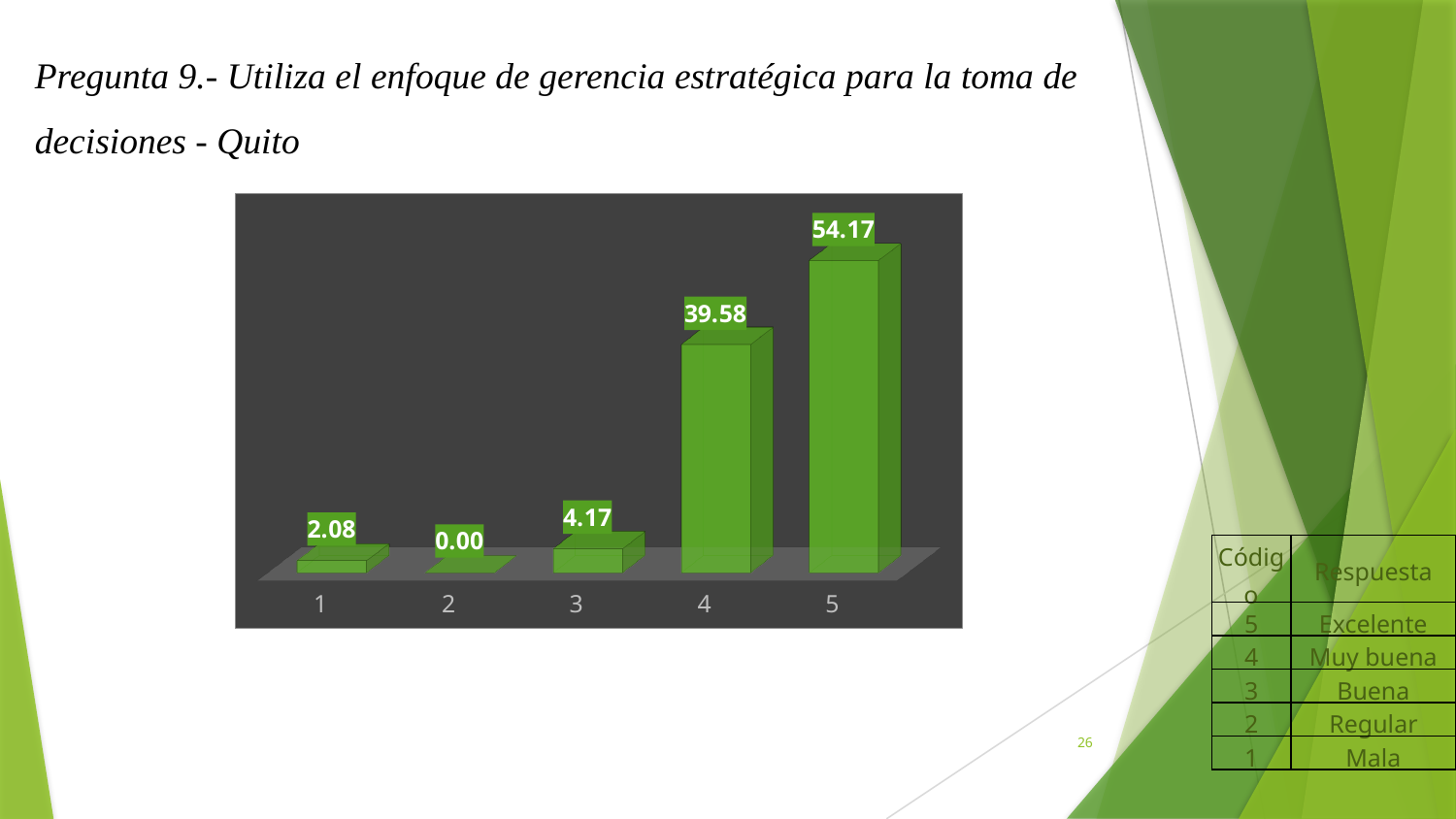
What colour are the bars in the chart? green What kind of chart is shown on the slide? bar chart Which category has the lowest value? 2 What is the difference between the values for category 5 and category 4? 14.59 What is the value for category 5? 54.17 What is the value for category 2? 0.00 Which category has the highest value? 5 What is the value for category 1? 2.08 What is the value for category 4? 39.58 How many categories are shown on the x axis? 5 What is the value for category 3? 4.17 Which is larger, the value for category 3 or the value for category 1? 3